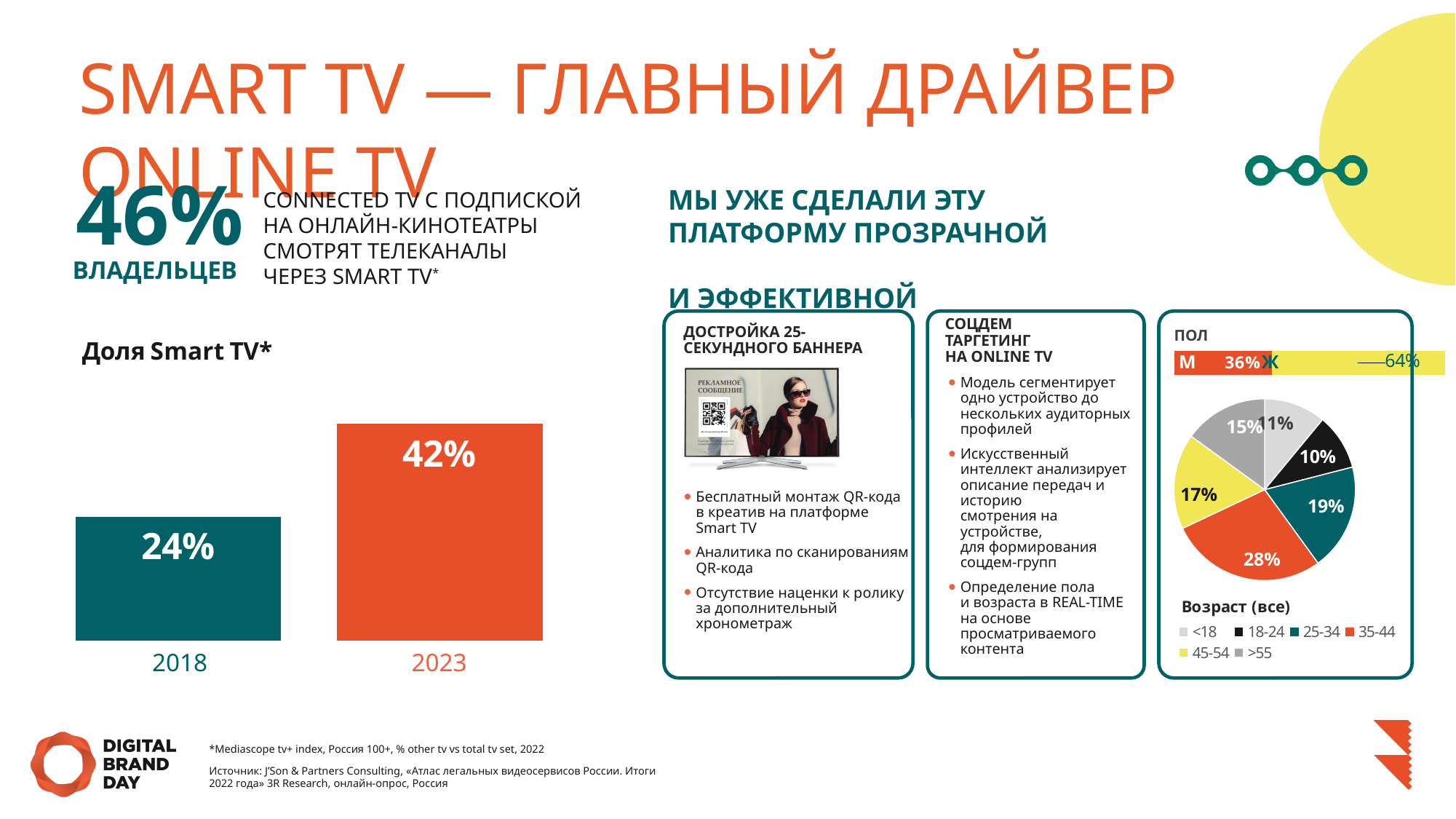
In the 'Доля Smart TV*' bar chart, do the values rise or fall from 2018 to 2023? rise In the 'Возраст (все)' pie chart, what is the share of the 35-44 group? 28% How many bars are in the 'Доля Smart TV*' chart? 2 How many categories does the legend of the 'Возраст (все)' pie chart list? 6 What kind of chart is 'Доля Smart TV*'? bar chart In the 'Доля Smart TV*' bar chart, what is the value for 2018? 24% In the 'Возраст (все)' pie chart, which age group has the largest share? 35-44 In the 'Доля Smart TV*' bar chart, what is the difference between the 2023 and 2018 values? 18% In the 'Возраст (все)' pie chart, which age group has the smallest share? 18-24 In the 'Возраст (все)' pie chart, which is larger: the 45-54 share or the >55 share? 45-54 In the 'Доля Smart TV*' bar chart, what is the value for 2023? 42% In the 'Возраст (все)' pie chart, what is the share of the 25-34 group? 19%